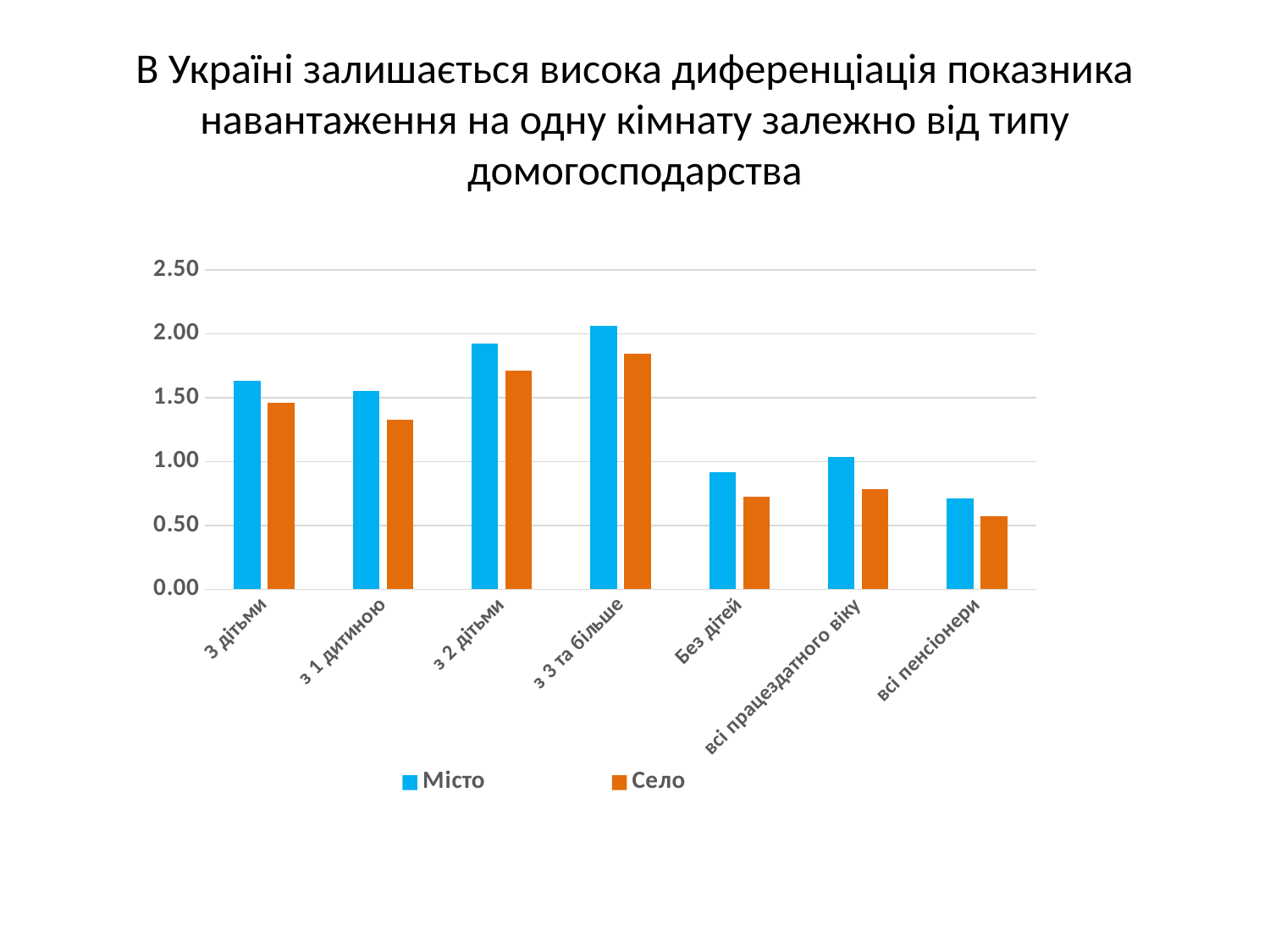
Is the value for Село in the category всі пенсіонери greater or less than 0.50? greater Is the value for Місто in the category Без дітей greater or less than 1.00? less How many household categories are shown on the x axis? 7 Which category has the lowest value for Село? всі пенсіонери Which category has the lowest value for Місто? всі пенсіонери In the category з 1 дитиною, which series has the larger value, Місто or Село? Місто What kind of chart is shown on the slide? bar chart Is the value for Село in the category з 3 та більше greater or less than 2.00? less Which category has the highest value for Місто? з 3 та більше How many series does the legend list? 2 Which colour represents the Село series in the chart? orange